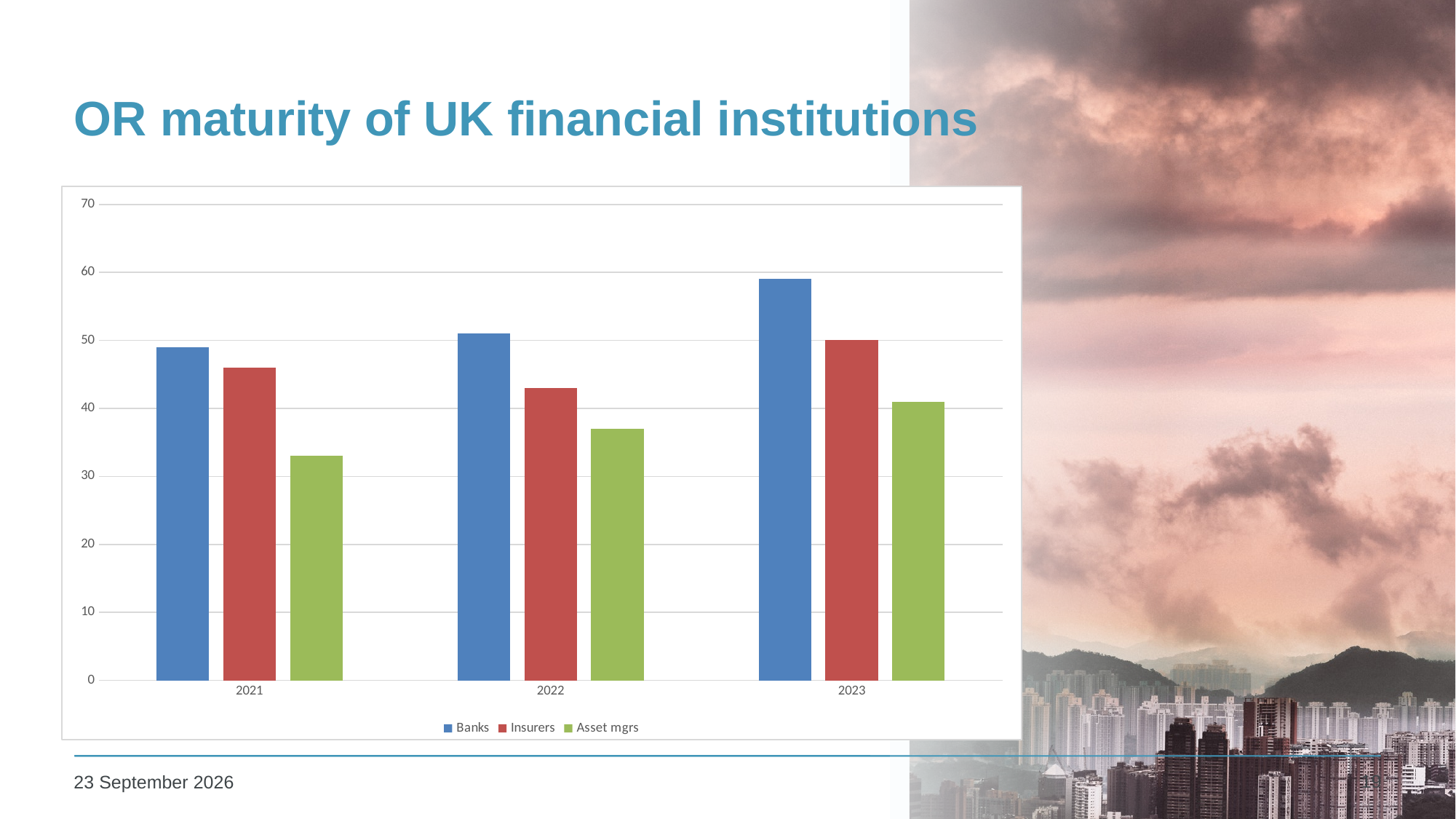
Do the values for Asset mgrs rise or fall from 2021 to 2023? rise Which is larger in 2023, Insurers or Asset mgrs? Insurers What kind of chart is shown on the slide? bar chart Is the value for Insurers in 2021 greater or less than 50? less How many series does the legend list? 3 Which series has the highest bar in 2023? Banks How many years are shown on the x axis? 3 Is the value for Asset mgrs in 2022 greater or less than 40? less What colour are the Banks bars? blue Is the value for Asset mgrs in 2021 greater or less than 40? less Which series has the lowest bar in 2021? Asset mgrs